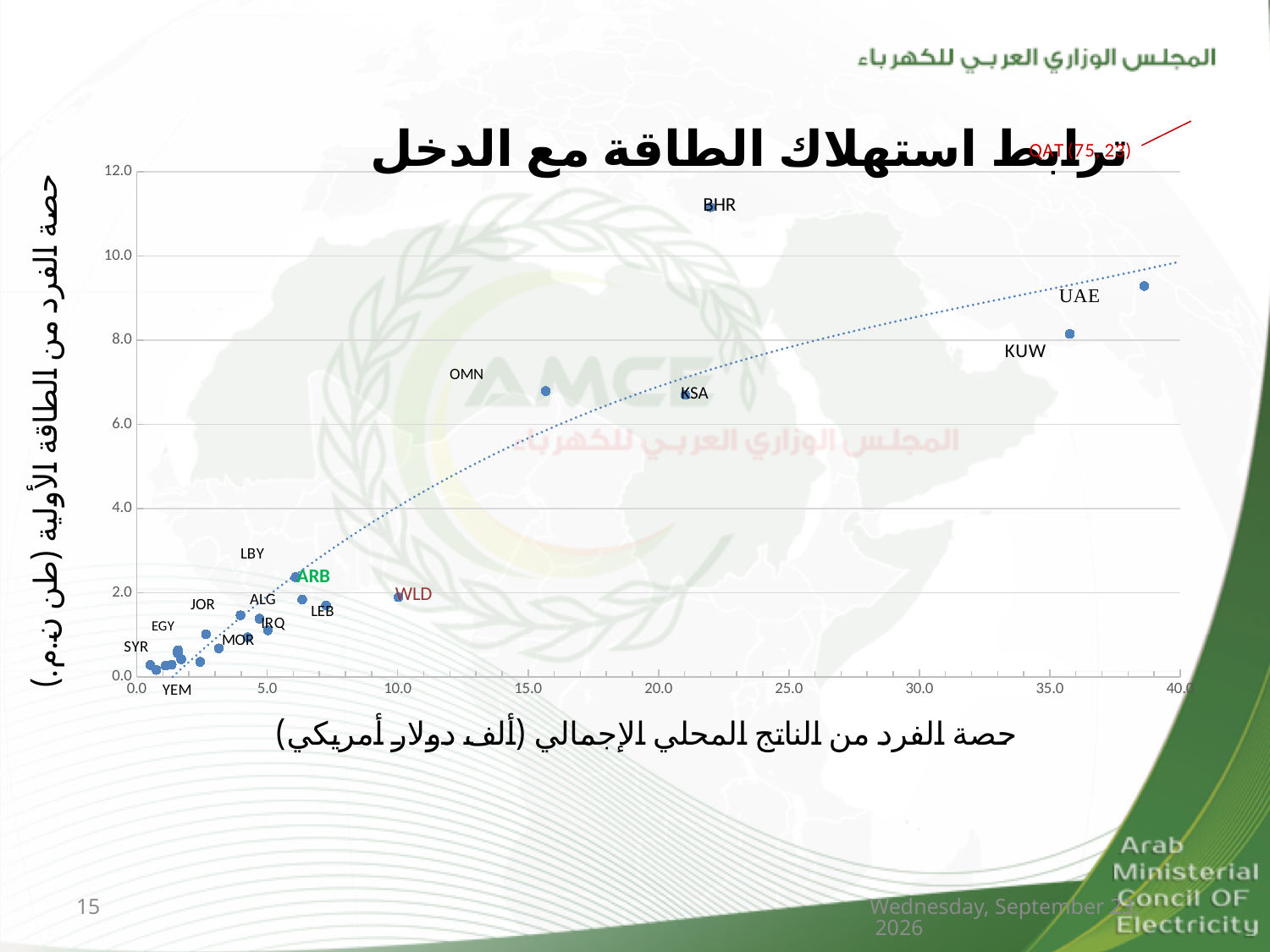
What coordinates are printed in the annotation for QAT? (75, 23) Is the per-capita energy value (y-axis) for WLD greater or less than 4.0? less Which has the higher per-capita energy value (y-axis), BHR or UAE? BHR Does the dotted trend line rise or fall as per-capita GDP increases along the x-axis? rises Is the per-capita GDP value (x-axis) for KUW greater or less than 30.0? greater Which labelled country has the highest per-capita GDP (x-axis) among the plotted points? UAE Which labelled country has the highest per-capita primary energy share (y-axis) among the plotted points? BHR Is the per-capita GDP value (x-axis) for OMN greater or less than 15.0? greater What kind of chart is shown on the slide? scatter chart Which has the higher per-capita GDP value (x-axis), KSA or OMN? KSA